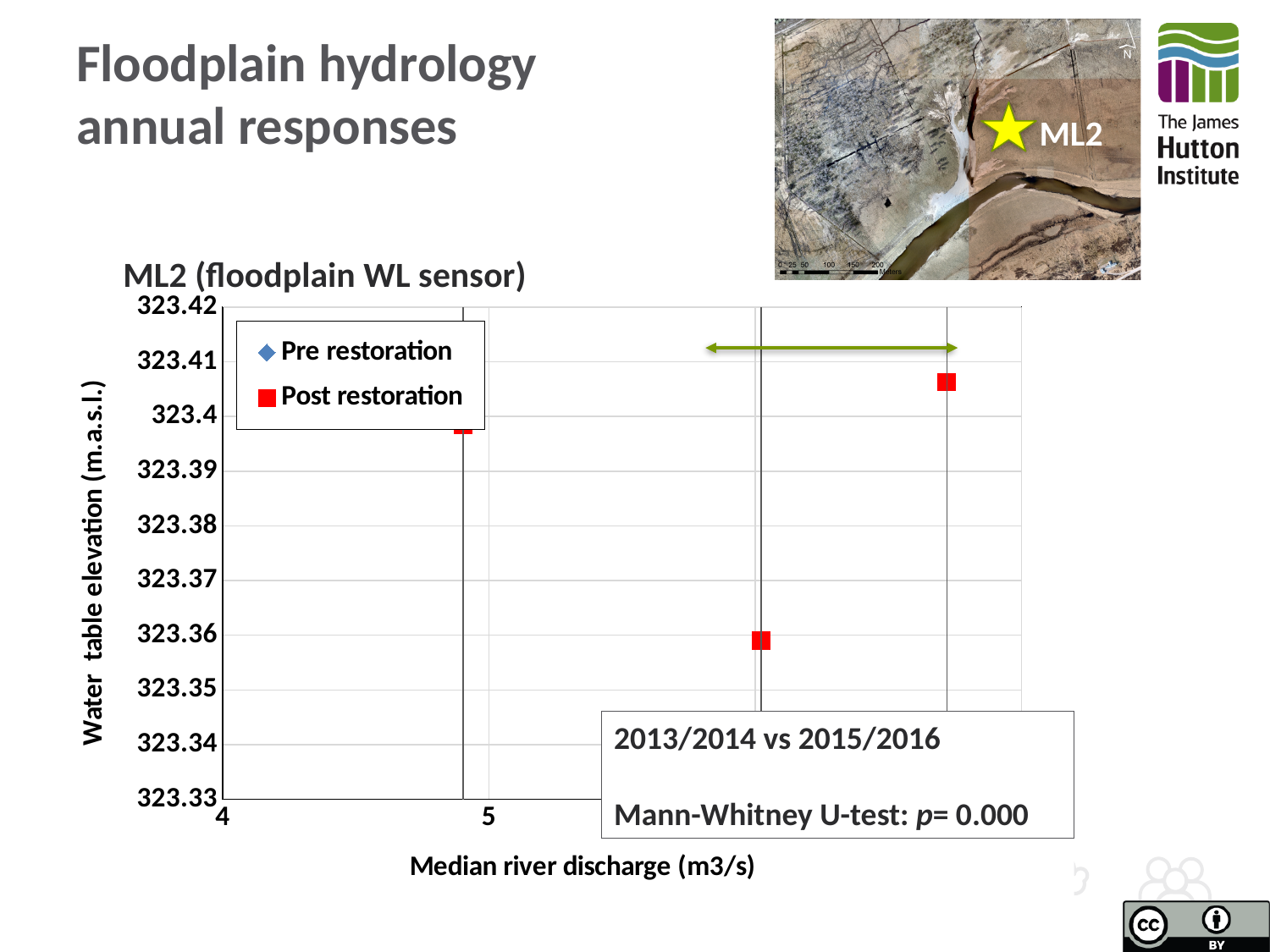
What is the highest value shown on the y axis? 323.42 What is the lowest value shown on the y axis? 323.33 Which has the higher water table elevation: the leftmost Post restoration point or the rightmost Post restoration point? the rightmost What kind of chart is shown on the slide? scatter chart Is the water table elevation of the rightmost Post restoration point greater or less than 323.4? greater How many series does the legend of the ML2 chart list? 2 What is the label of the y axis? Water table elevation (m.a.s.l.) Which Post restoration point has the lowest water table elevation: the leftmost, the middle, or the rightmost? the middle What is the first tick value shown on the x axis? 4 What is the title of the chart? ML2 (floodplain WL sensor) Is the water table elevation of the leftmost Post restoration point greater or less than 323.39? greater Is the water table elevation of the middle Post restoration point greater or less than 323.37? less